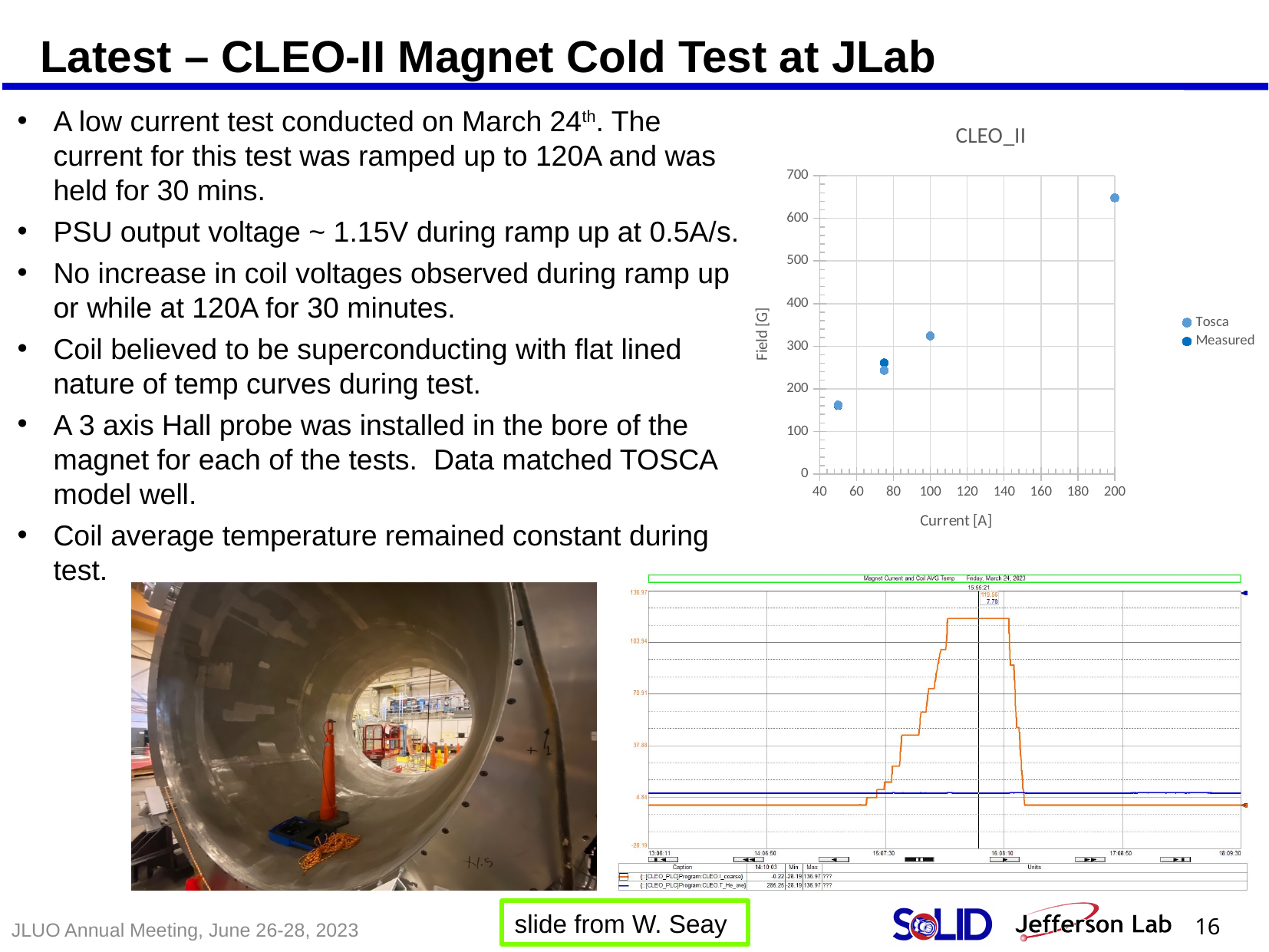
What kind of chart is the CLEO_II chart? scatter chart In the CLEO_II chart, is the field value at 200 A greater or less than 600? greater In the CLEO_II chart, does the field rise or fall as the current increases? rises In the CLEO_II chart, at which current is the lowest field value plotted? 50 A In the CLEO_II chart, is the field value at 50 A greater or less than 200? less In the CLEO_II chart, is the field value at 100 A greater or less than 400? less In the CLEO_II chart, at which current is the highest field value plotted? 200 A What are the two legend entries on the CLEO_II chart? Tosca and Measured What is the y-axis title of the CLEO_II chart? Field [G] How many series does the legend of the CLEO_II chart list? 2 In the CLEO_II chart, which is larger: the field at 100 A or the field at 50 A? the field at 100 A